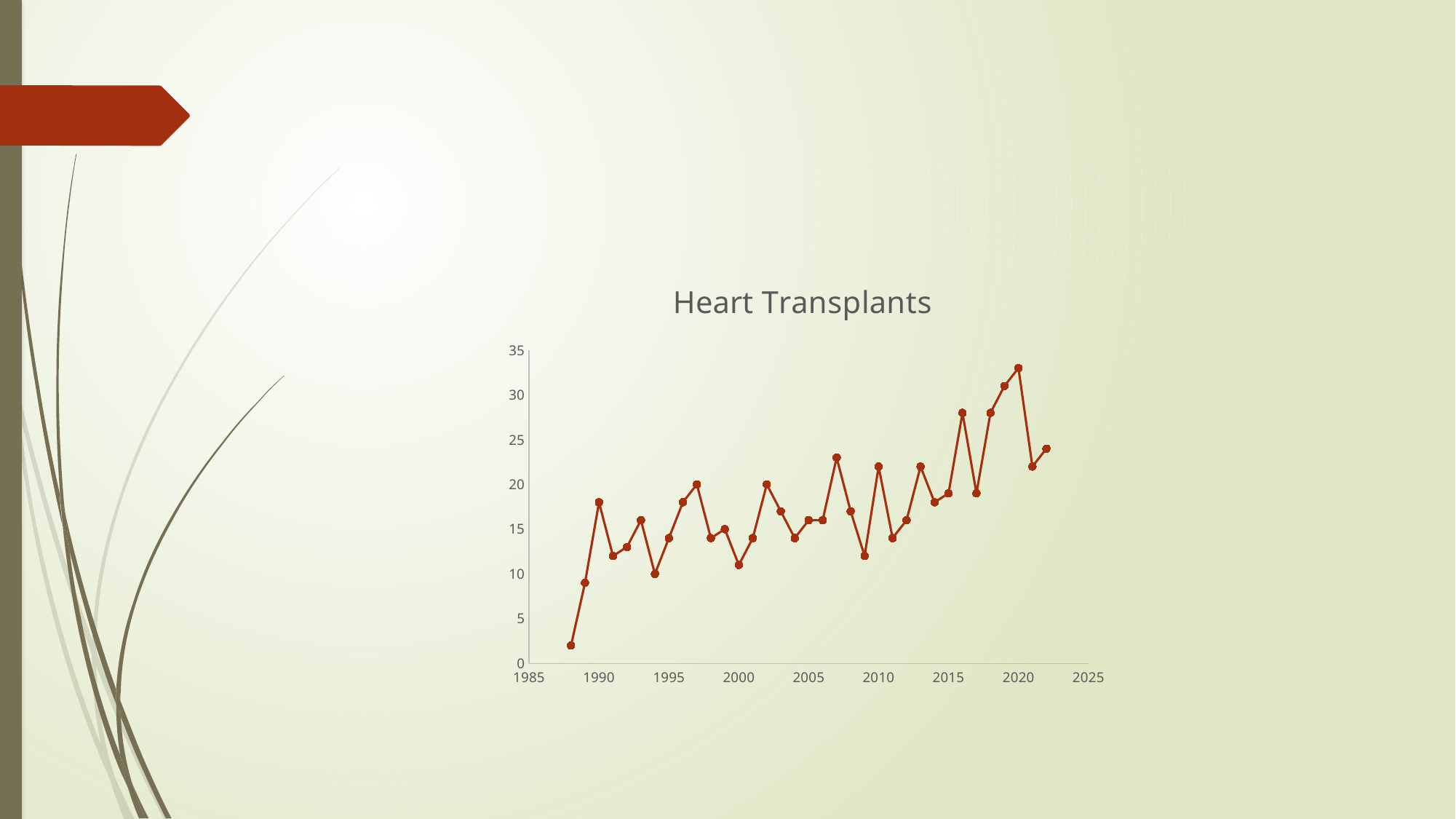
Is the value for 2000 greater or less than 15? less Is the value for 2016 greater or less than 25? greater Which year has the larger value, 1990 or 1991? 1990 Is the value for 2020 greater or less than 30? greater Which year has the larger value, 2020 or 2021? 2020 Around which year does the line reach its highest point? 2020 What is the title of the chart? Heart Transplants What kind of chart is shown on the slide? line chart Around which year does the line reach its lowest point? 1988 Overall, do the values rise or fall from 1988 to 2022? rise